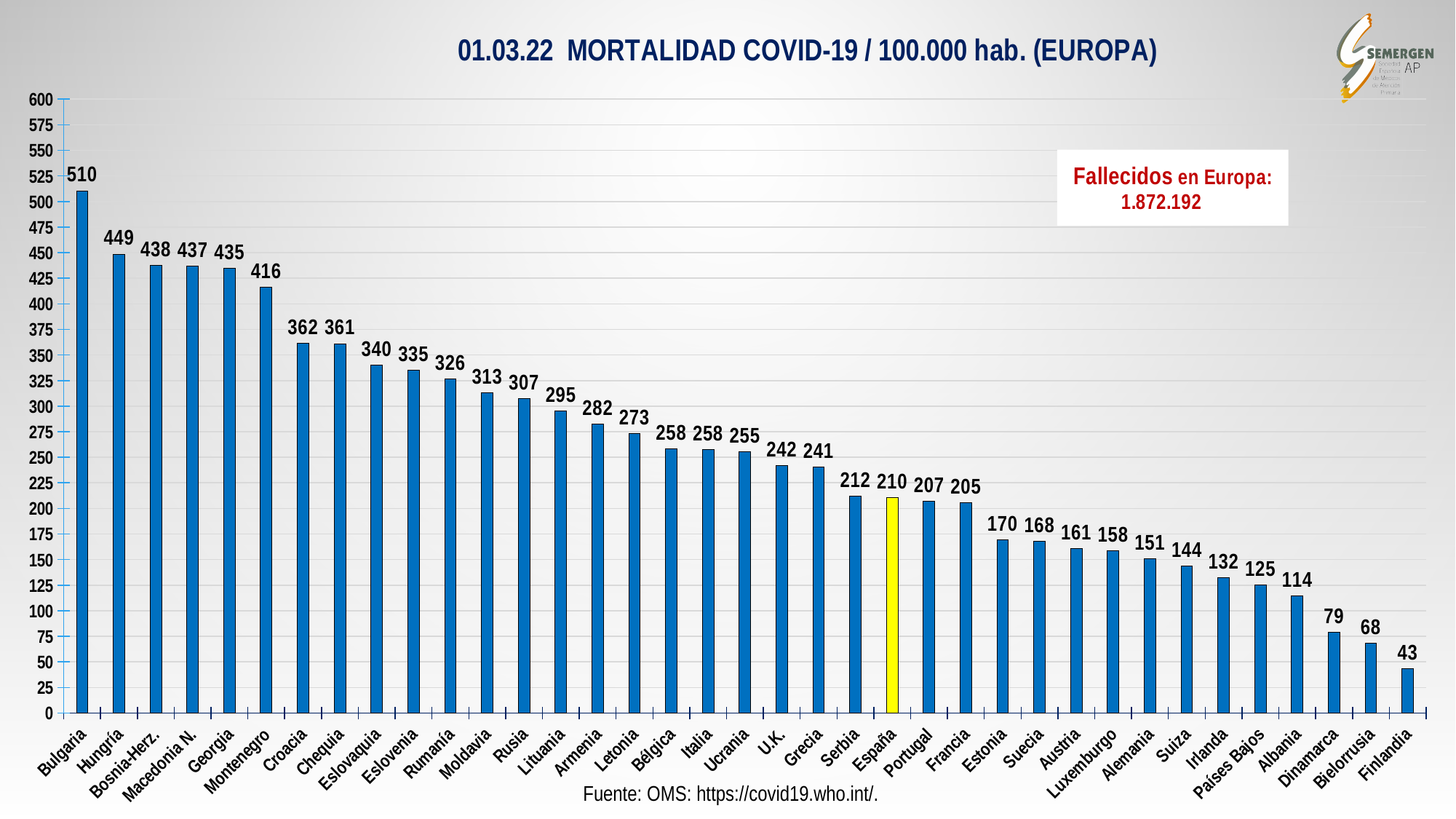
Which has a larger value, Portugal or Francia? Portugal What is the value for Alemania? 151 How many countries are shown in the chart? 37 What kind of chart is shown on the slide? Bar chart Which country has the highest value? Bulgaria Which bar is highlighted in yellow? España What is the difference between the values for Bulgaria and Finlandia? 467 Which country has the lowest value? Finlandia Which has a larger value, Croacia or Rusia? Croacia What is the difference between the values for Hungría and España? 239 What is the value for Bulgaria? 510 What is the value for España? 210